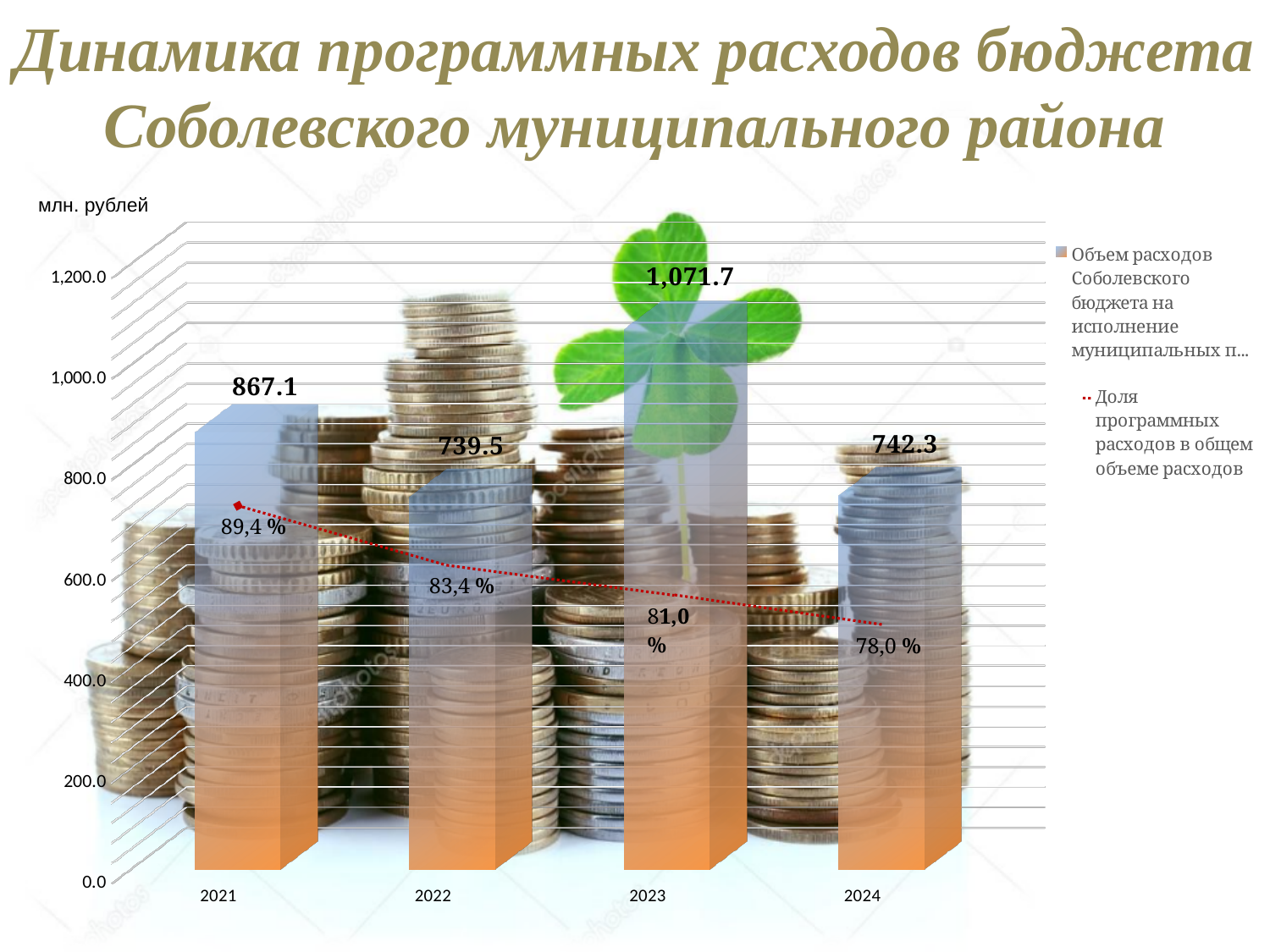
What share of total expenditures did programme expenditures make up in 2022? 83,4 % In which year is the volume of programme expenditures the lowest? 2022 How many years are shown on the x axis of the chart? 4 What share of total expenditures did programme expenditures make up in 2024? 78,0 % What is the volume of expenditures on municipal programmes in 2021? 867.1 Which year has a larger volume of programme expenditures, 2021 or 2023? 2023 Does the share of programme expenditures in total expenditures rise or fall from 2021 to 2024? fall What is the difference between the share of programme expenditures in 2021 and in 2024? 11,4 % What is the volume of expenditures on municipal programmes in 2023? 1,071.7 How many series does the chart legend list? 2 In which year is the volume of programme expenditures the highest? 2023 By how much does the volume of programme expenditures in 2023 exceed that in 2021? 204.6